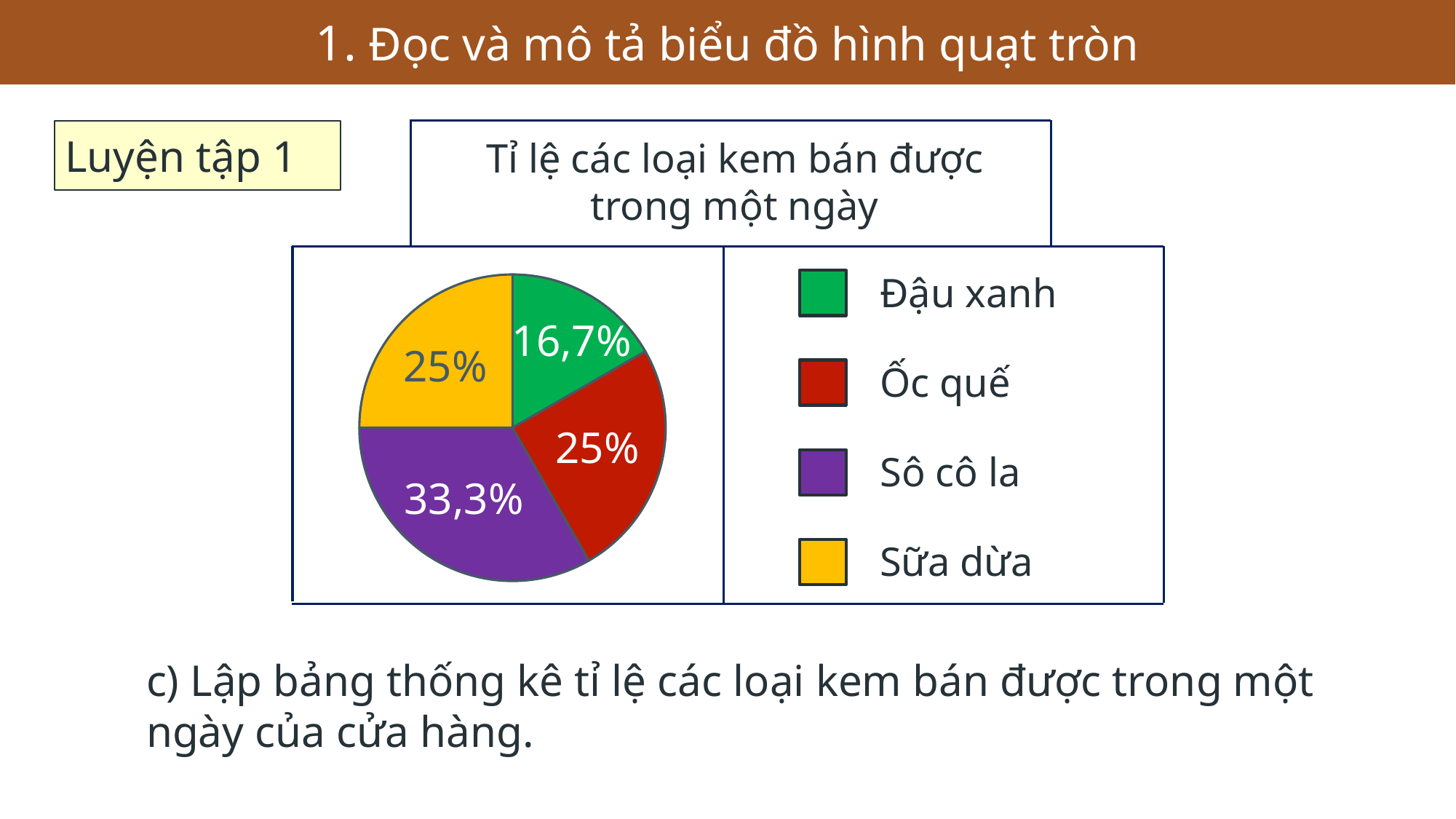
Which type of ice cream has the largest share of sales? Sô cô la What kind of chart is shown on the slide? Pie chart What percentage of ice cream sold is Ốc quế? 25% Which type of ice cream has the smallest share of sales? Đậu xanh What is the difference in percentage points between the Sô cô la share and the Đậu xanh share? 16,6 What percentage of ice cream sold is Đậu xanh? 16,7% What percentage of ice cream sold is Sữa dừa? 25% Which has a larger share, Sô cô la or Ốc quế? Sô cô la Which colour represents Sữa dừa in the chart? Yellow What is the title of the chart? Tỉ lệ các loại kem bán được trong một ngày What percentage of ice cream sold is Sô cô la? 33,3% How many types of ice cream are shown in the pie chart? 4